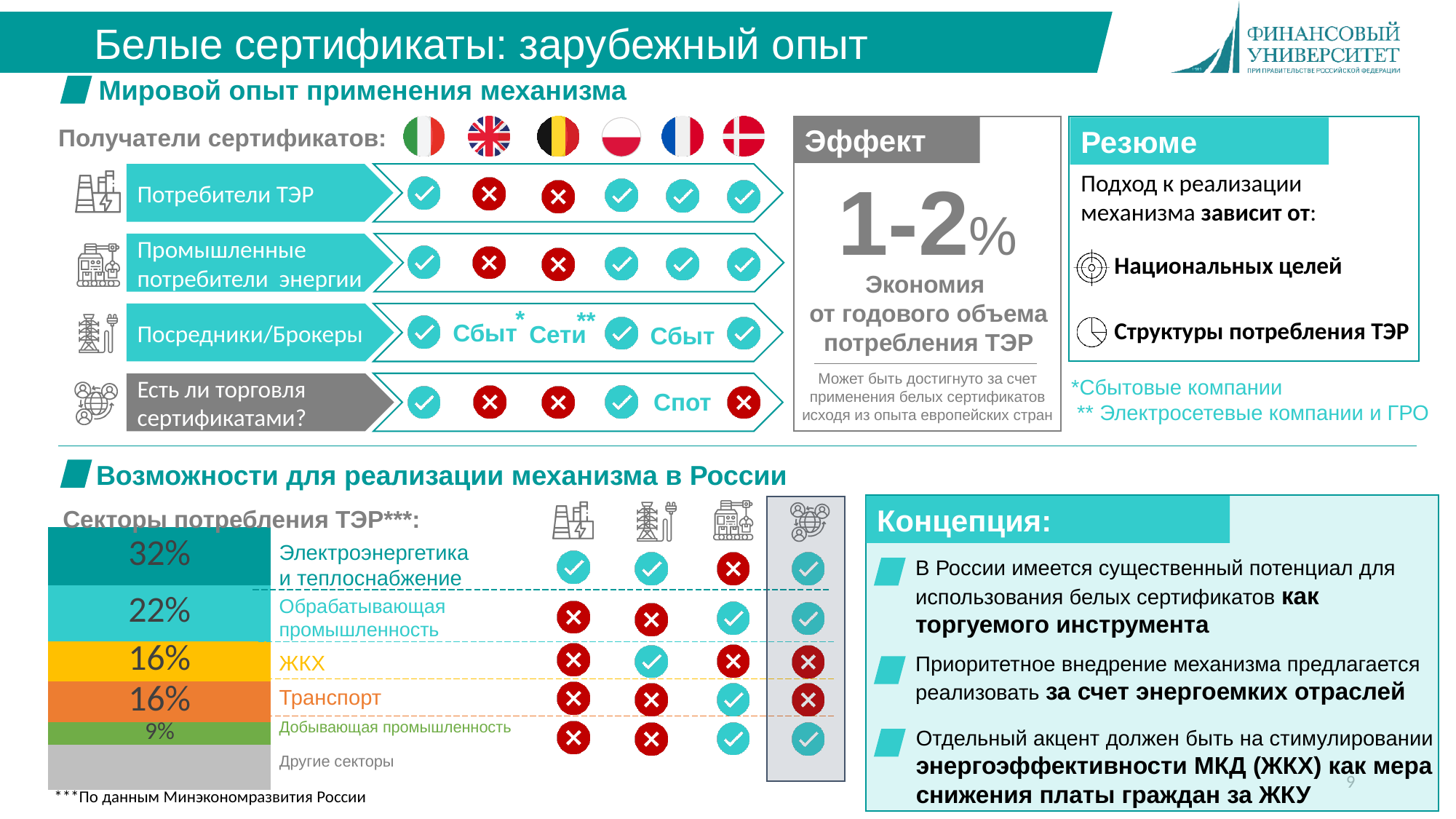
What kind of chart is the 'Секторы потребления ТЭР' chart? Stacked bar chart In the 'Секторы потребления ТЭР' chart, which of the sectors with a printed percentage has the smallest share? Добывающая промышленность How many sectors are listed in the 'Секторы потребления ТЭР' chart? 6 In the 'Секторы потребления ТЭР' chart, by how many percentage points does Электроэнергетика и теплоснабжение exceed Обрабатывающая промышленность? 10 percentage points In the 'Секторы потребления ТЭР' chart, what share is shown for Транспорт? 16% In the 'Секторы потребления ТЭР' chart, what share is shown for Обрабатывающая промышленность? 22% In the 'Секторы потребления ТЭР' chart, by how many percentage points does Обрабатывающая промышленность exceed Добывающая промышленность? 13 percentage points In the 'Секторы потребления ТЭР' chart, what share is shown for Добывающая промышленность? 9% In the 'Секторы потребления ТЭР' chart, which sector has the largest share? Электроэнергетика и теплоснабжение In the 'Секторы потребления ТЭР' chart, what share is shown for ЖКХ? 16% In the 'Секторы потребления ТЭР' chart, what share is shown for Электроэнергетика и теплоснабжение? 32% In the 'Секторы потребления ТЭР' chart, which is larger: Обрабатывающая промышленность or Транспорт? Обрабатывающая промышленность